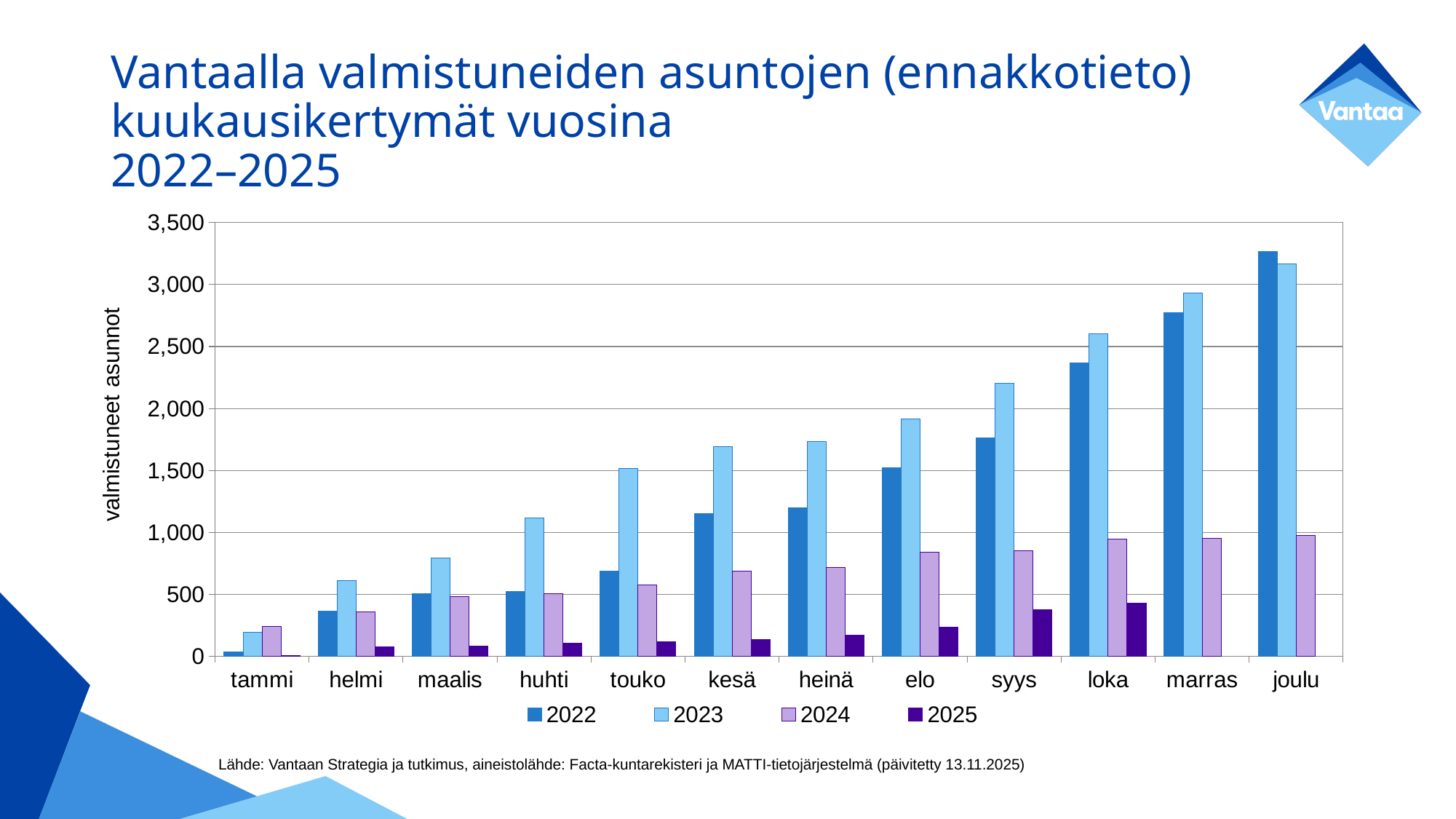
Is the 2024 value for touko greater or less than 500? greater What kind of chart is shown on the slide? bar chart For loka, which series has the larger value, 2022 or 2023? 2023 How many months are shown along the x axis? 12 Which month has the lowest value for the 2025 series? tammi Is the 2023 value for joulu greater or less than 3,000? greater Which month has the highest value for the 2022 series? joulu Is the 2022 value for loka greater or less than 2,500? less Do the values of the 2024 series rise or fall from tammi to joulu? rise How many series does the legend list? 4 What is the label on the vertical axis? valmistuneet asunnot